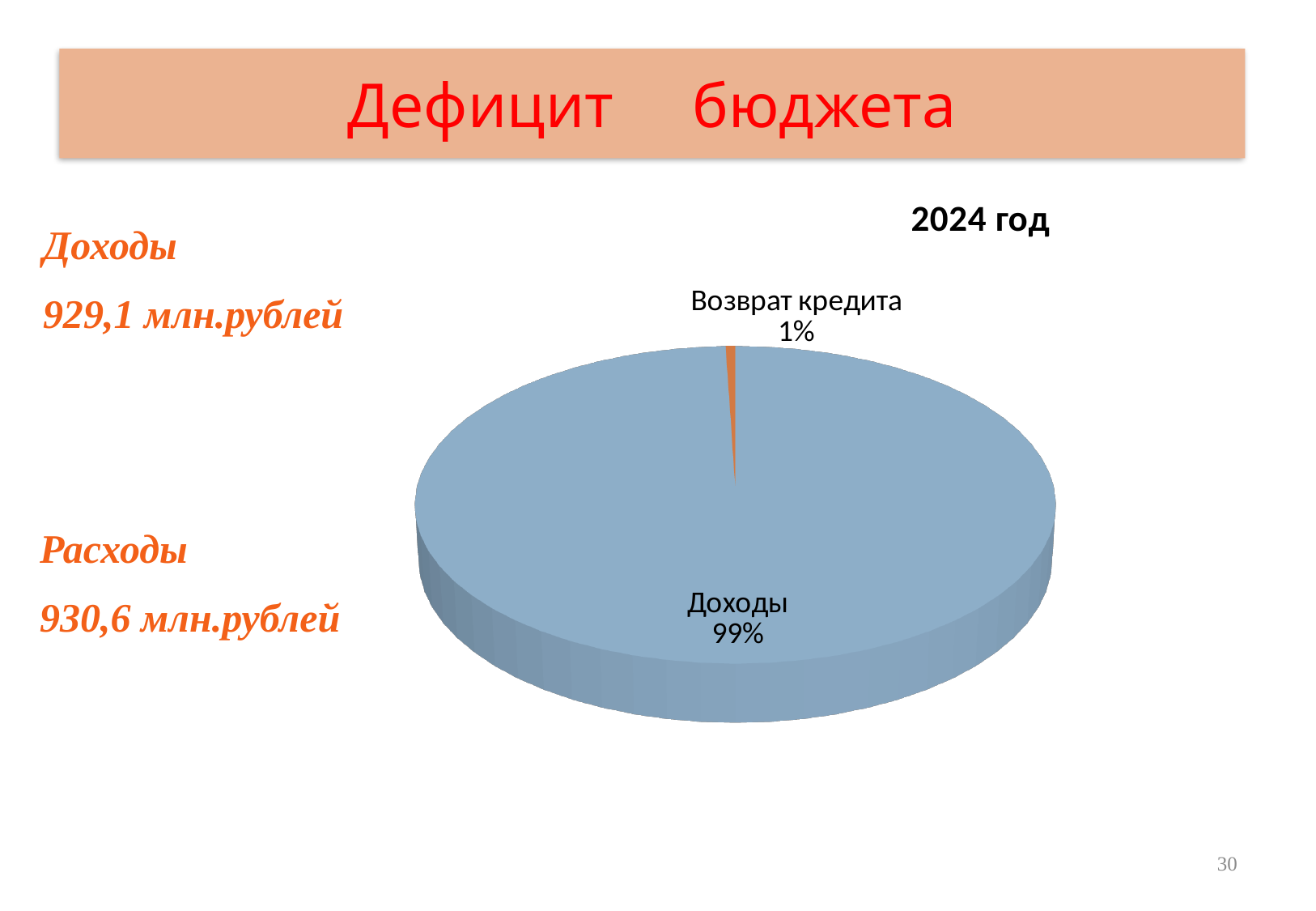
What colour is the Доходы slice of the pie? blue How many slices does the pie chart have? 2 What kind of chart is shown on the slide? pie chart Which slice of the pie is the largest? Доходы What year is shown above the pie chart? 2024 год What share of the pie does Возврат кредита take? 1% Which slice of the pie is the smallest? Возврат кредита What is the difference in percentage points between the Доходы slice and the Возврат кредита slice? 98 Which is larger, the share for Доходы or the share for Возврат кредита? Доходы What share of the pie does Доходы take? 99%